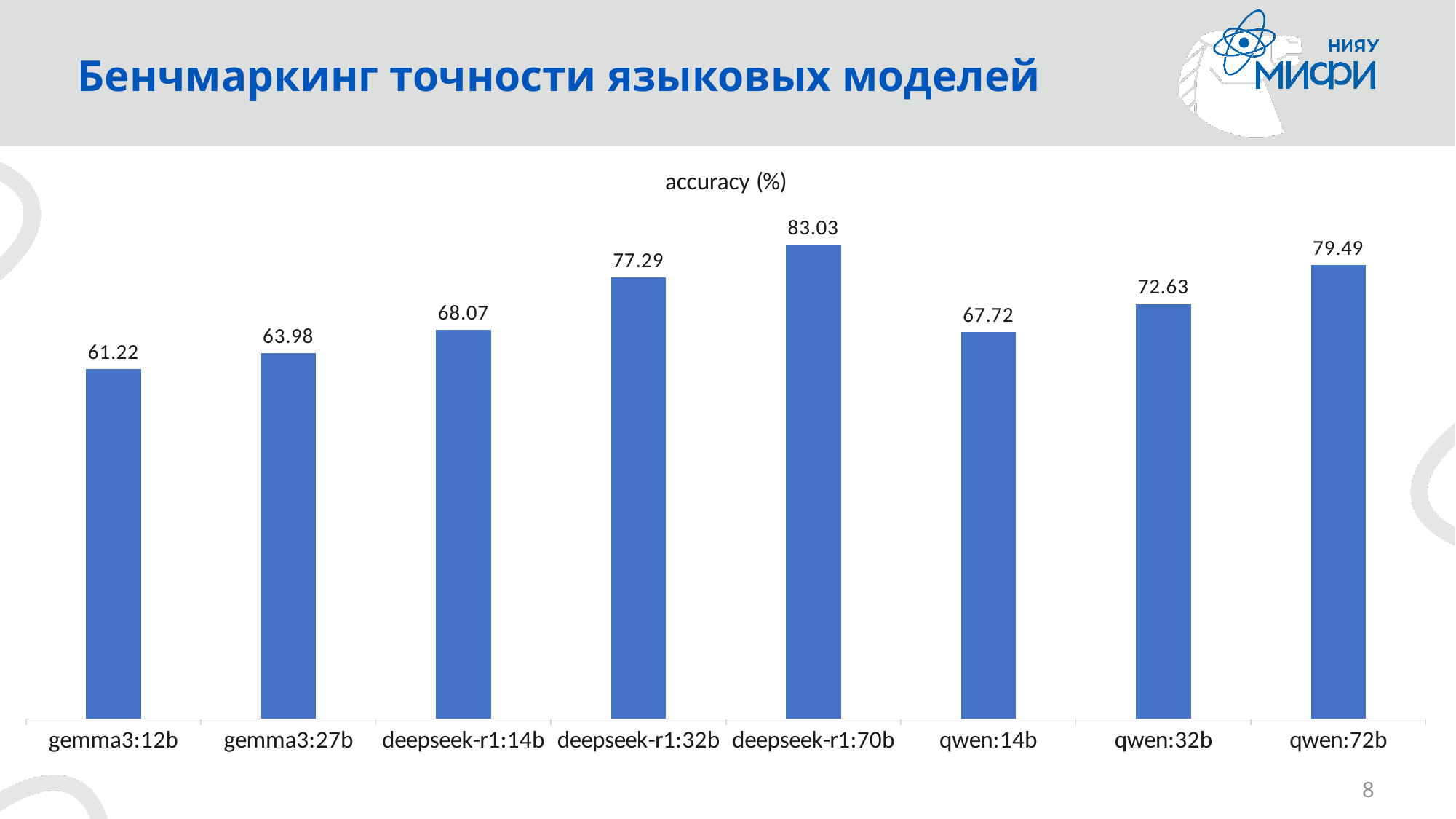
What is the accuracy (%) for deepseek-r1:70b? 83.03 What is the difference in accuracy (%) between deepseek-r1:70b and qwen:72b? 3.54 Which model has the lowest accuracy (%)? gemma3:12b Which has a higher accuracy (%): qwen:72b or deepseek-r1:32b? qwen:72b Which model has the highest accuracy (%)? deepseek-r1:70b What is the accuracy (%) for gemma3:12b? 61.22 What is the accuracy (%) for qwen:32b? 72.63 Which has a higher accuracy (%): deepseek-r1:14b or qwen:14b? deepseek-r1:14b How many models are shown in the chart? 8 What is the title of the chart? accuracy (%) What is the difference in accuracy (%) between gemma3:27b and gemma3:12b? 2.76 What kind of chart is shown on the slide? Bar chart